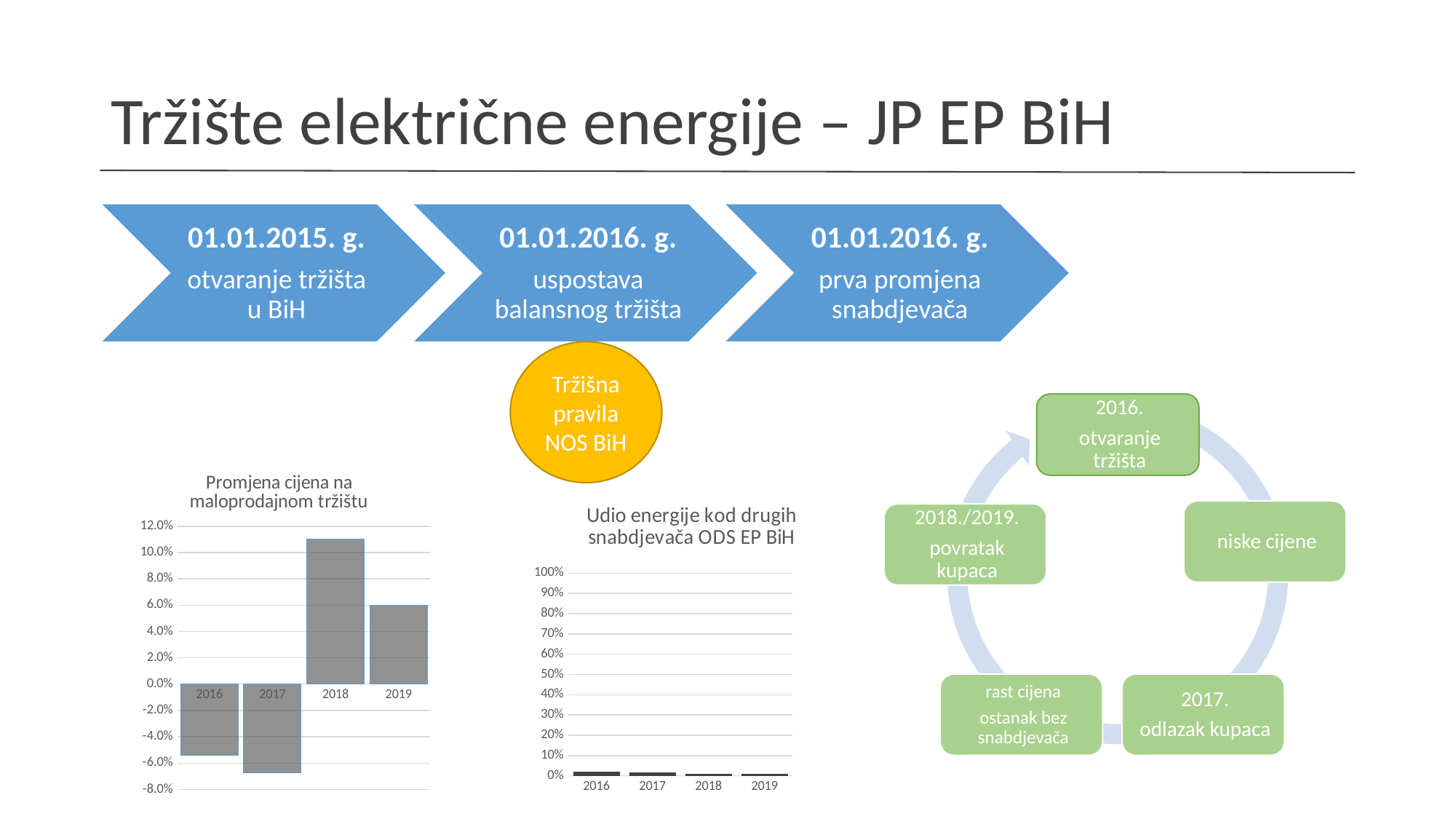
On the chart titled 'Promjena cijena na maloprodajnom tržištu', is the value for 2018 greater or less than 10.0%? greater On the chart titled 'Udio energije kod drugih snabdjevača ODS EP BiH', what is the highest value shown on the y axis? 100% On the chart titled 'Udio energije kod drugih snabdjevača ODS EP BiH', how many years are shown on the x axis? 4 On the chart titled 'Promjena cijena na maloprodajnom tržištu', is the value for 2019 greater or less than 4.0%? greater On the chart titled 'Promjena cijena na maloprodajnom tržištu', which is larger, the value for 2018 or the value for 2019? 2018 On the chart titled 'Promjena cijena na maloprodajnom tržištu', which year has the lowest value? 2017 On the chart titled 'Promjena cijena na maloprodajnom tržištu', how many years are shown on the x axis? 4 On the chart titled 'Promjena cijena na maloprodajnom tržištu', is the value for 2016 greater or less than -4.0%? less On the chart titled 'Promjena cijena na maloprodajnom tržištu', which year has the highest value? 2018 What kind of chart is the one titled 'Promjena cijena na maloprodajnom tržištu'? bar chart